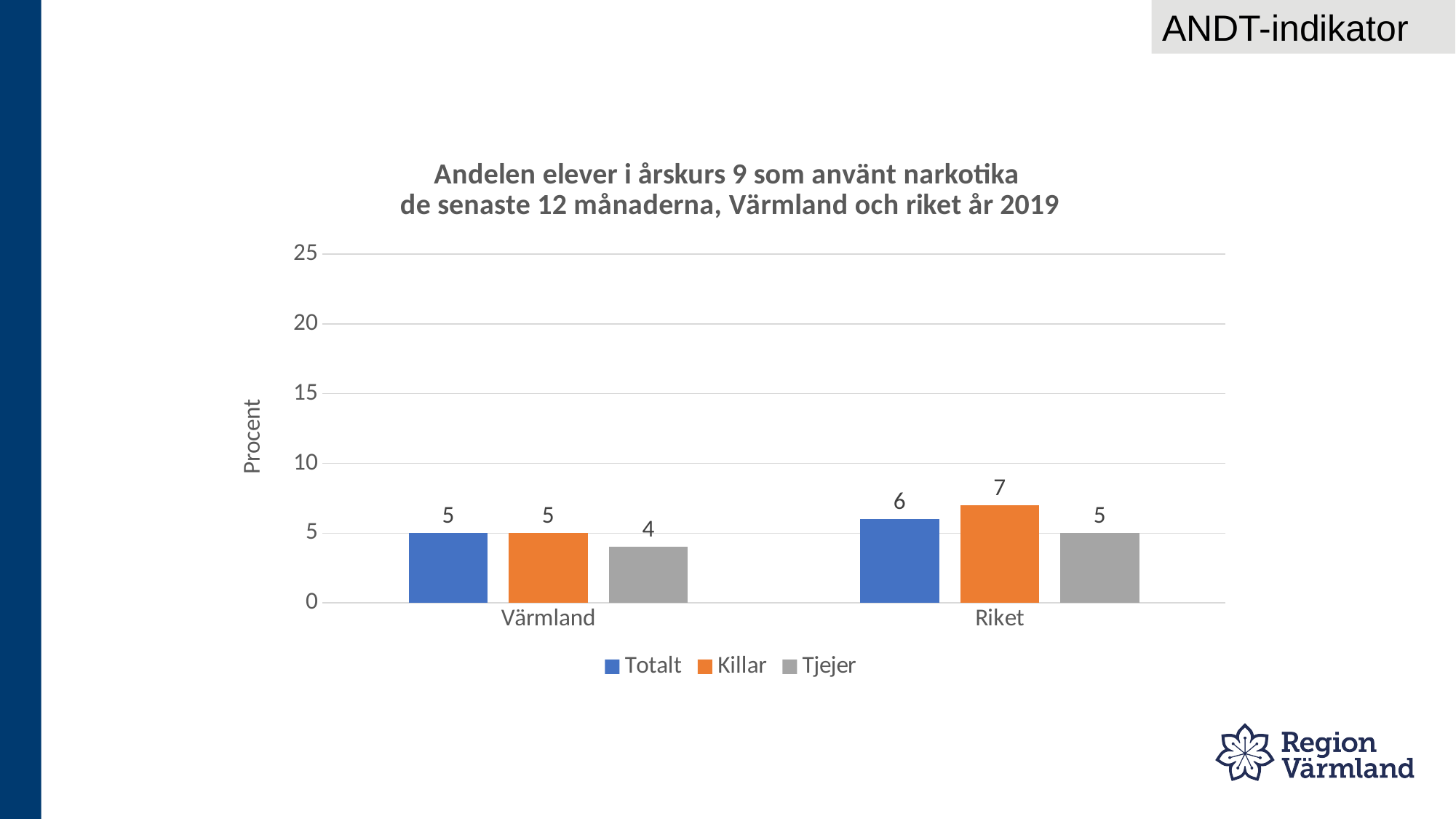
What is the value for Totalt in Riket? 6 How many series does the legend list? 3 What is the value for Totalt in Värmland? 5 Which series has the highest value in Riket? Killar What is the value for Tjejer in Värmland? 4 Which is larger, the Tjejer value in Riket or the Tjejer value in Värmland? Riket What is the difference between the Killar value in Riket and the Killar value in Värmland? 2 Which series has the lowest value in Värmland? Tjejer What is the label of the y axis? Procent What kind of chart is shown on the slide? Bar chart How many categories are shown on the x axis? 2 What is the value for Killar in Riket? 7